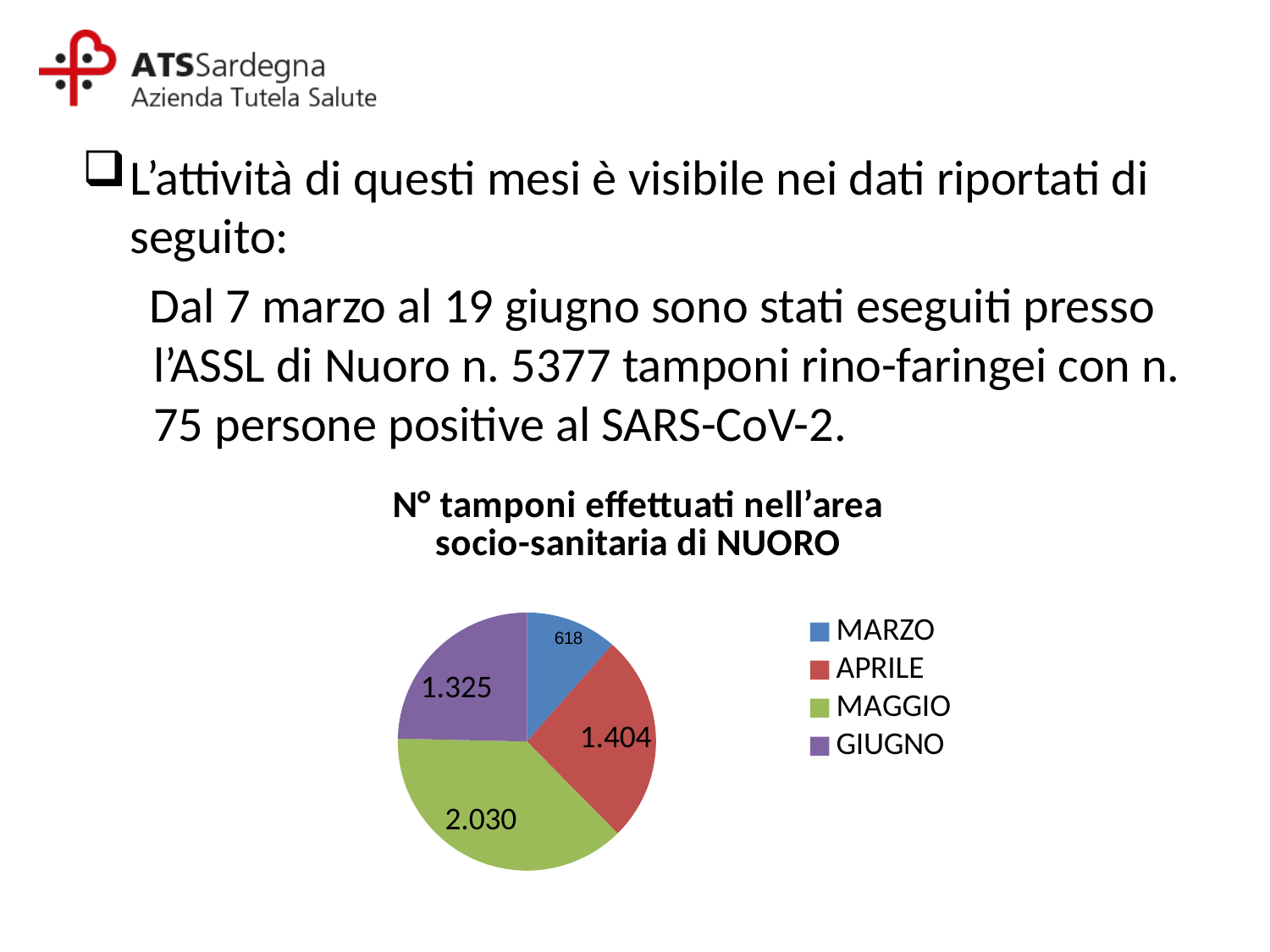
What is the value for GIUGNO? 1.325 What type of chart is shown on the slide? pie chart What is the value for APRILE? 1.404 How many entries does the legend list? 4 What is the difference between the values for MAGGIO and APRILE? 626 Which month has the smallest slice? MARZO What is the title of the chart? N° tamponi effettuati nell'area socio-sanitaria di NUORO Which month has the largest slice? MAGGIO Which is larger, the value for APRILE or the value for GIUGNO? APRILE What is the value for MAGGIO? 2.030 How many slices does the pie chart have? 4 What is the value for MARZO? 618